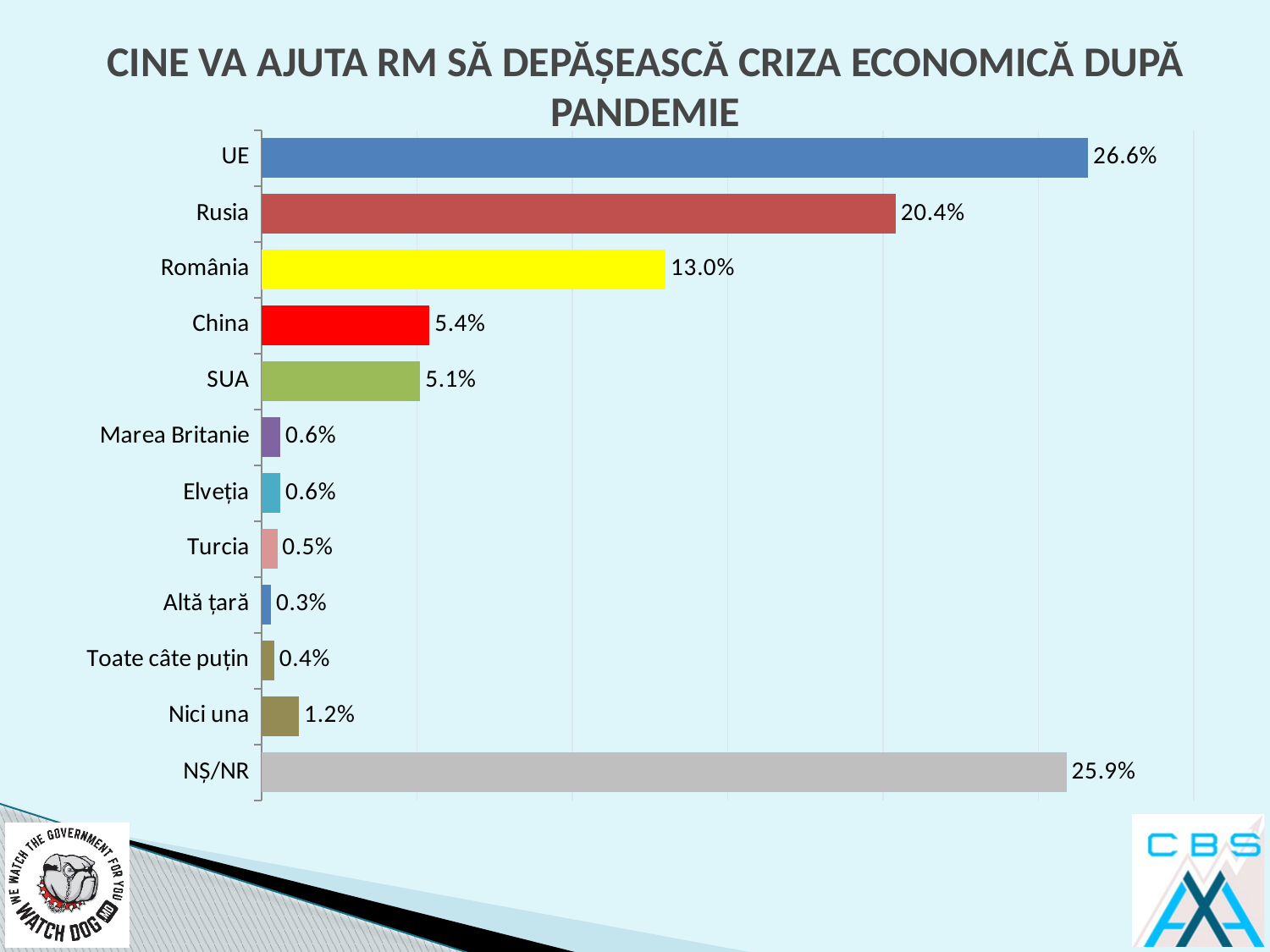
What kind of chart is shown on the slide? Bar chart Which category has the highest value? UE What is the value for Rusia? 20.4% What is the value for UE? 26.6% Which category has the lowest value? Altă țară What is the difference between the values for UE and Rusia? 6.2% What colour is the bar for România? Yellow What is the value for NȘ/NR? 25.9% How many categories are shown in the chart? 12 What is the difference between the values for Nici una and Toate câte puțin? 0.8% Which is larger, the value for China or the value for SUA? China What is the value for România? 13.0%